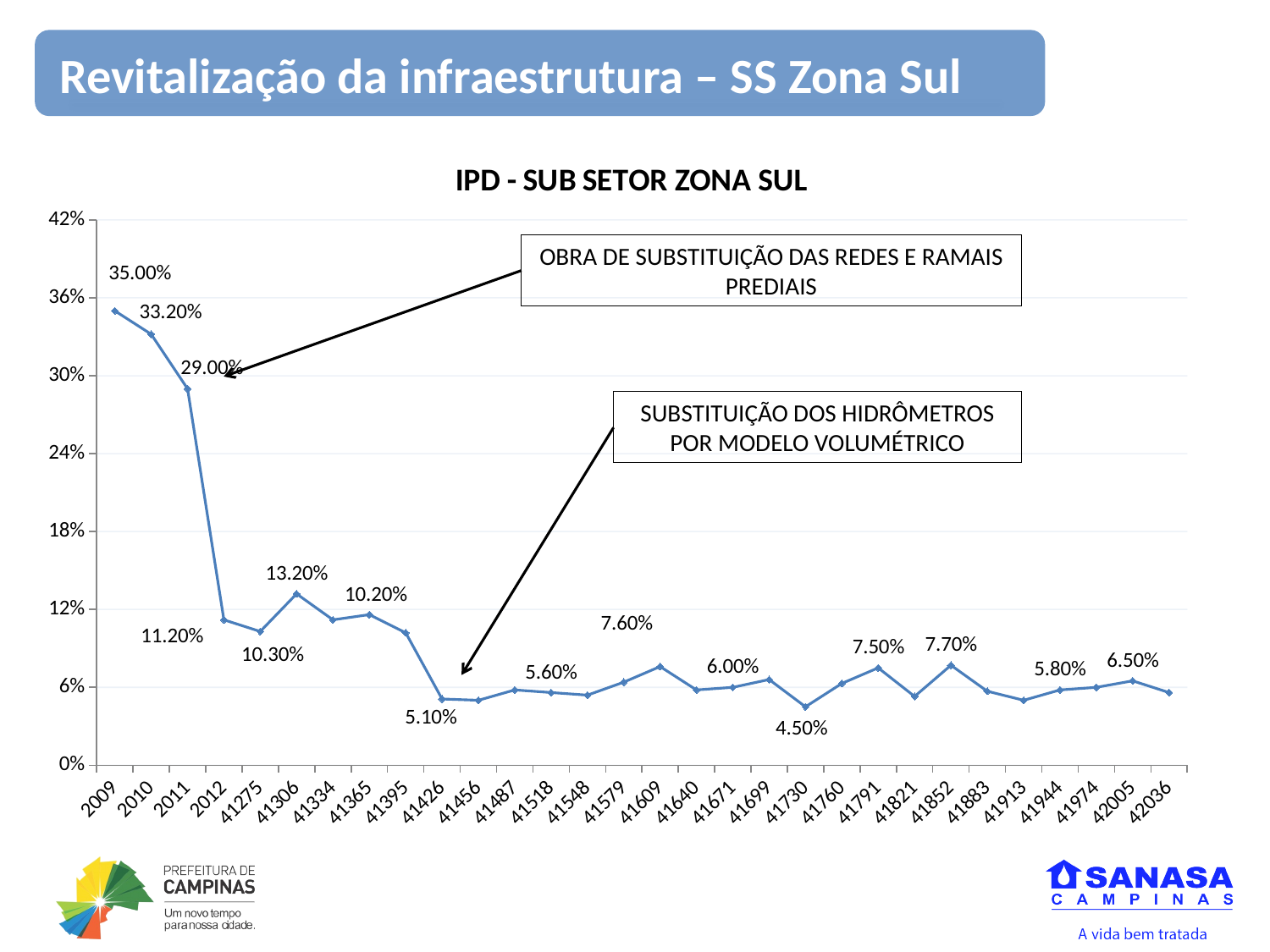
What is the title of the chart? IPD - SUB SETOR ZONA SUL Which category has the lowest value? 41730 Which category has the highest value? 2009 What is the difference between the values for 2010 and 2011? 4.20% Does the value generally rise or fall from 2009 to 42036? fall Is the value for 2012 greater or less than 12%? less What is the value for 2011? 29.00% What type of chart is shown on the slide? Line chart What is the value for 41730? 4.50% What is the value for 2009? 35.00% What is the value for 41306? 13.20% Which is larger, the value for 41852 or the value for 42005? 41852